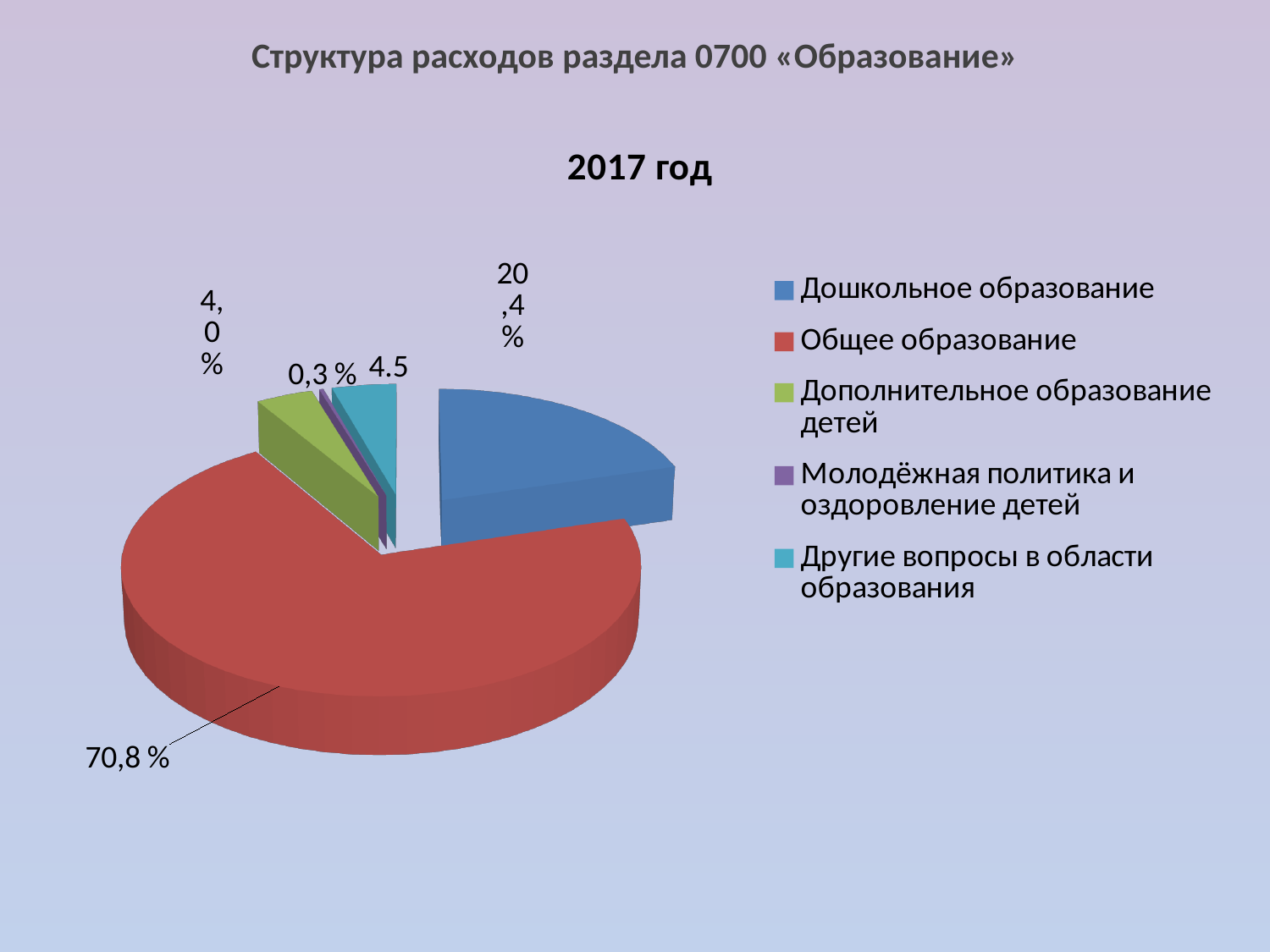
How many entries does the legend list? 5 What is the title shown above the pie chart? 2017 год How many slices does the pie chart have? 5 What colour is the slice for Общее образование? red What kind of chart is shown on the slide? pie chart Which category has the largest slice of the pie? Общее образование Which is larger, the slice for Общее образование or the slice for Дошкольное образование? Общее образование What share of expenses is labelled for Общее образование? 70,8 % What share of expenses is labelled for Дошкольное образование? 20,4 % What is the difference between the shares for Общее образование (70,8 %) and Дошкольное образование (20,4 %)? 50,4 % Which category has the smallest slice of the pie? Молодёжная политика и оздоровление детей What value is labelled for Молодёжная политика и оздоровление детей? 0,3 %